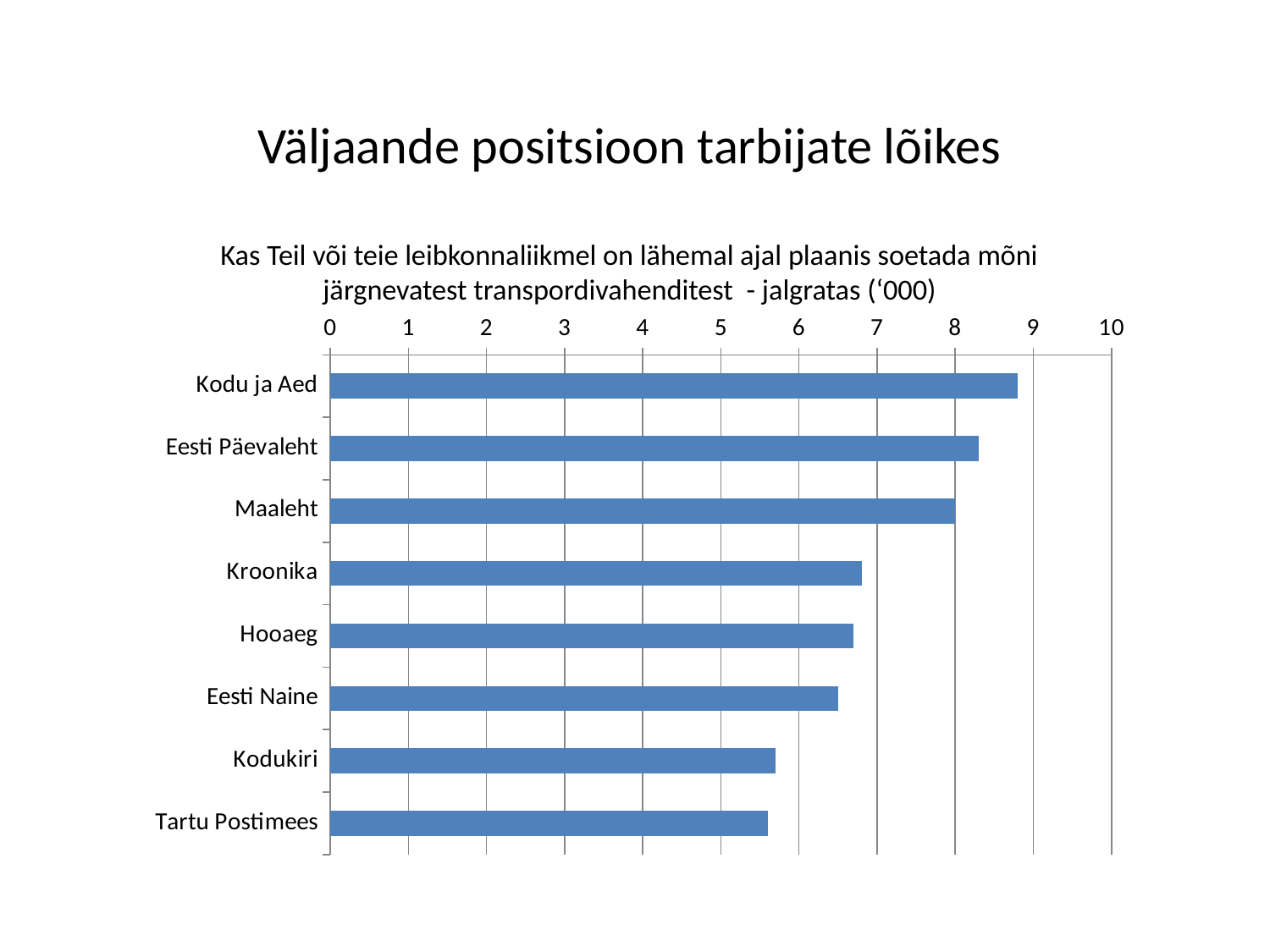
What is the title of the slide? Väljaande positsioon tarbijate lõikes Is the value for Eesti Naine greater or less than 6? greater Is the value for Kroonika greater or less than 7? less Which publication has the highest value on the chart? Kodu ja Aed Which has a larger value, Maaleht or Eesti Naine? Maaleht Is the value for Tartu Postimees greater or less than 5? greater How many publications are listed on the chart? 8 What kind of chart is shown on the slide? bar chart Which has a larger value, Kodu ja Aed or Kroonika? Kodu ja Aed